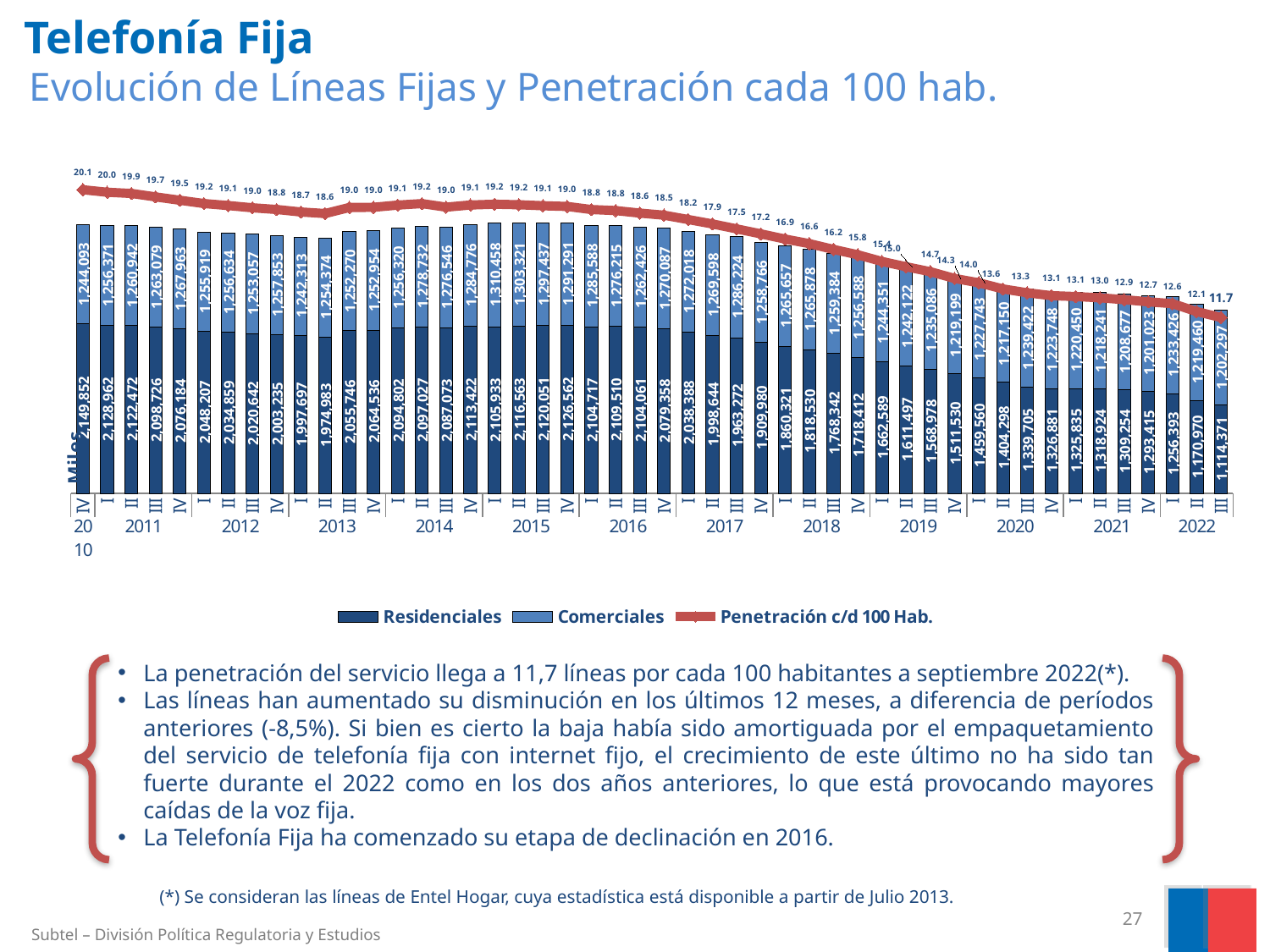
What is the difference between the Penetración c/d 100 Hab. value in quarter IV of 2010 and in quarter III of 2022? 8.4 How many series does the legend list? 3 In which quarter is the Comerciales value highest? I 2015 How many quarterly bars are plotted in the chart? 48 What is the total of the stacked bar (Residenciales plus Comerciales) for quarter III of 2022? 2,316,668 Does the Penetración c/d 100 Hab. line rise or fall from 2016 to 2022? Fall In which quarter is the Residenciales value lowest? III 2022 What is the Penetración c/d 100 Hab. value for quarter III of 2022? 11.7 What is the Comerciales value for quarter IV of 2010? 1,244,093 What is the Residenciales value for quarter III of 2022? 1,114,371 In quarter III of 2022, which is larger, Residenciales or Comerciales? Comerciales In which quarter is the Penetración c/d 100 Hab. line at its highest? IV 2010